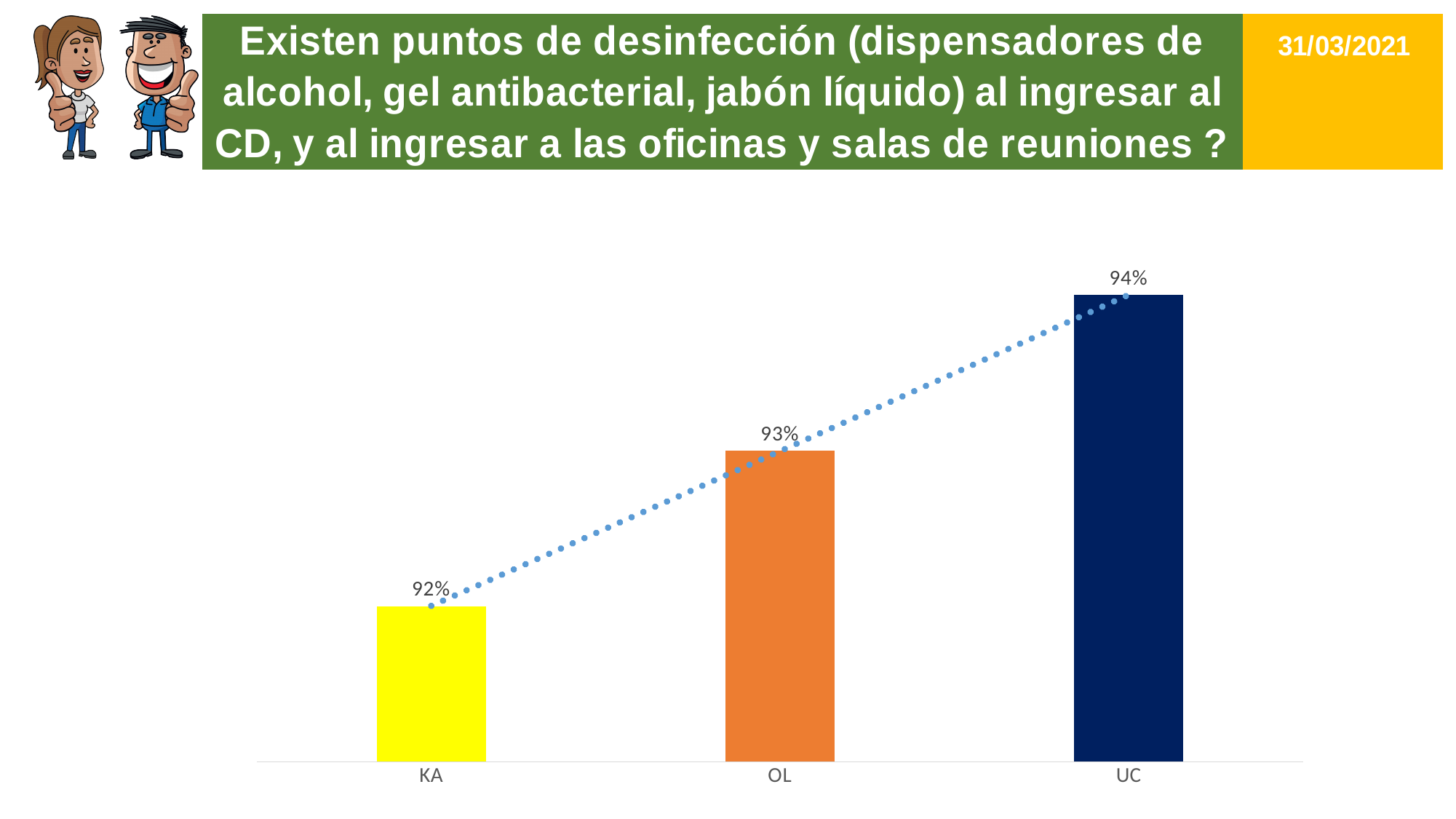
Which is larger, the value for OL or the value for UC? UC Which category has the highest value? UC What is the difference between the values for OL and KA? 1% What is the value for KA? 92% How many categories are shown on the x axis? 3 What colour is the bar for OL? Orange What is the value for UC? 94% Do the values rise or fall from KA to UC along the x axis? Rise What is the difference between the values for UC and KA? 2% What is the value for OL? 93% Which category has the lowest value? KA What kind of chart is shown on the slide? Bar chart